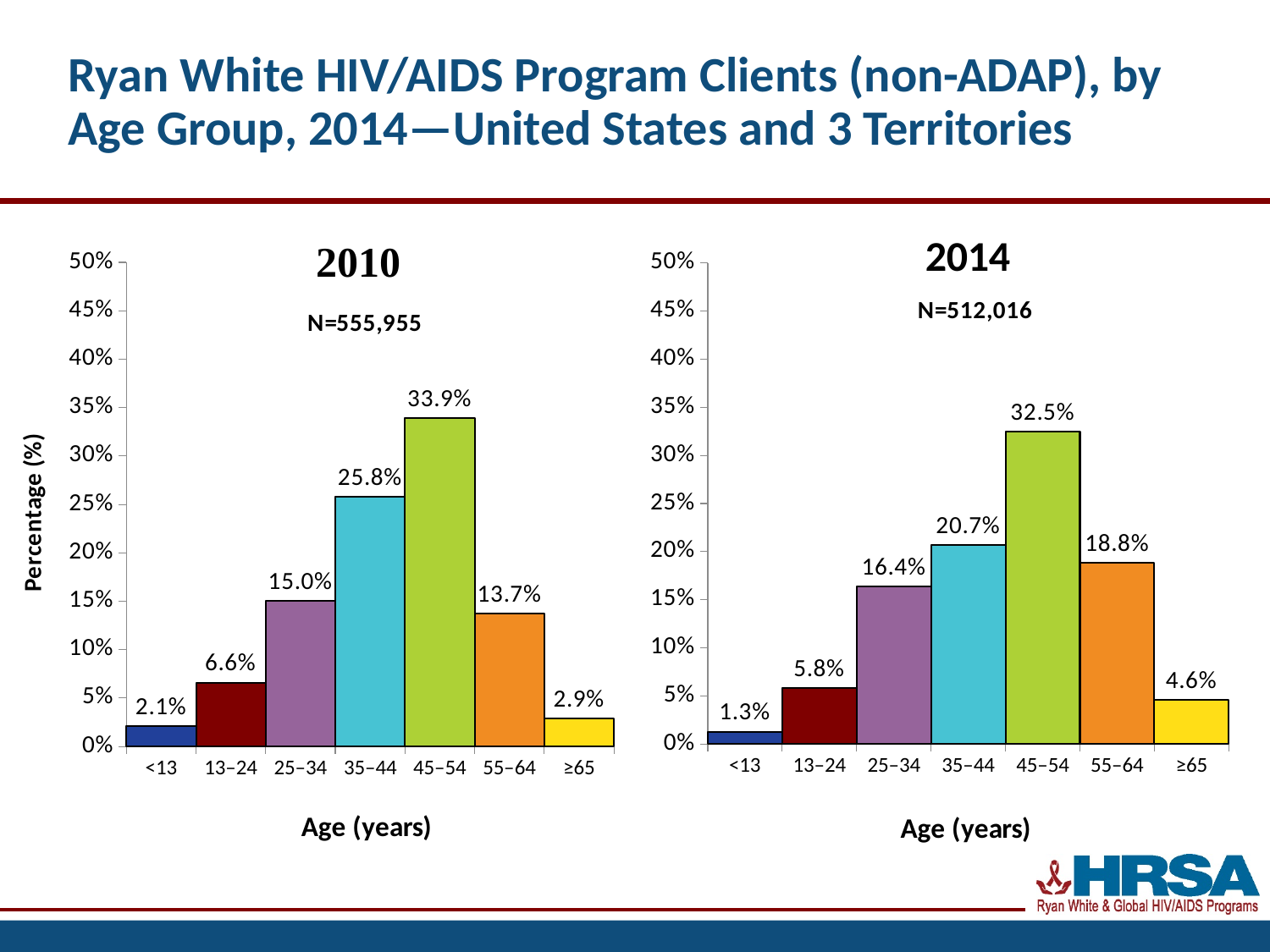
In the 2014 chart, what percentage of clients were aged 35–44? 20.7% In the 2010 chart, which age group has the lowest percentage? <13 In the 2014 chart, which age group has the highest percentage? 45–54 In the 2010 chart, do the values rise or fall from the 45–54 age group to the ≥65 age group? fall In the 2010 chart, what percentage of clients were aged 45–54? 33.9% What is the N value shown on the 2014 chart? N=512,016 In the 2014 chart, is the value for the 25–34 age group greater or less than 15%? greater What is the y-axis label on the 2010 chart? Percentage (%) What kind of chart is the 2014 chart? bar chart In the 2014 chart, what is the difference between the percentages for the 45–54 and 55–64 age groups? 13.7% In the 2010 chart, which is larger: the percentage for 13–24 or for ≥65? 13–24 How many age groups are shown in the 2010 chart? 7